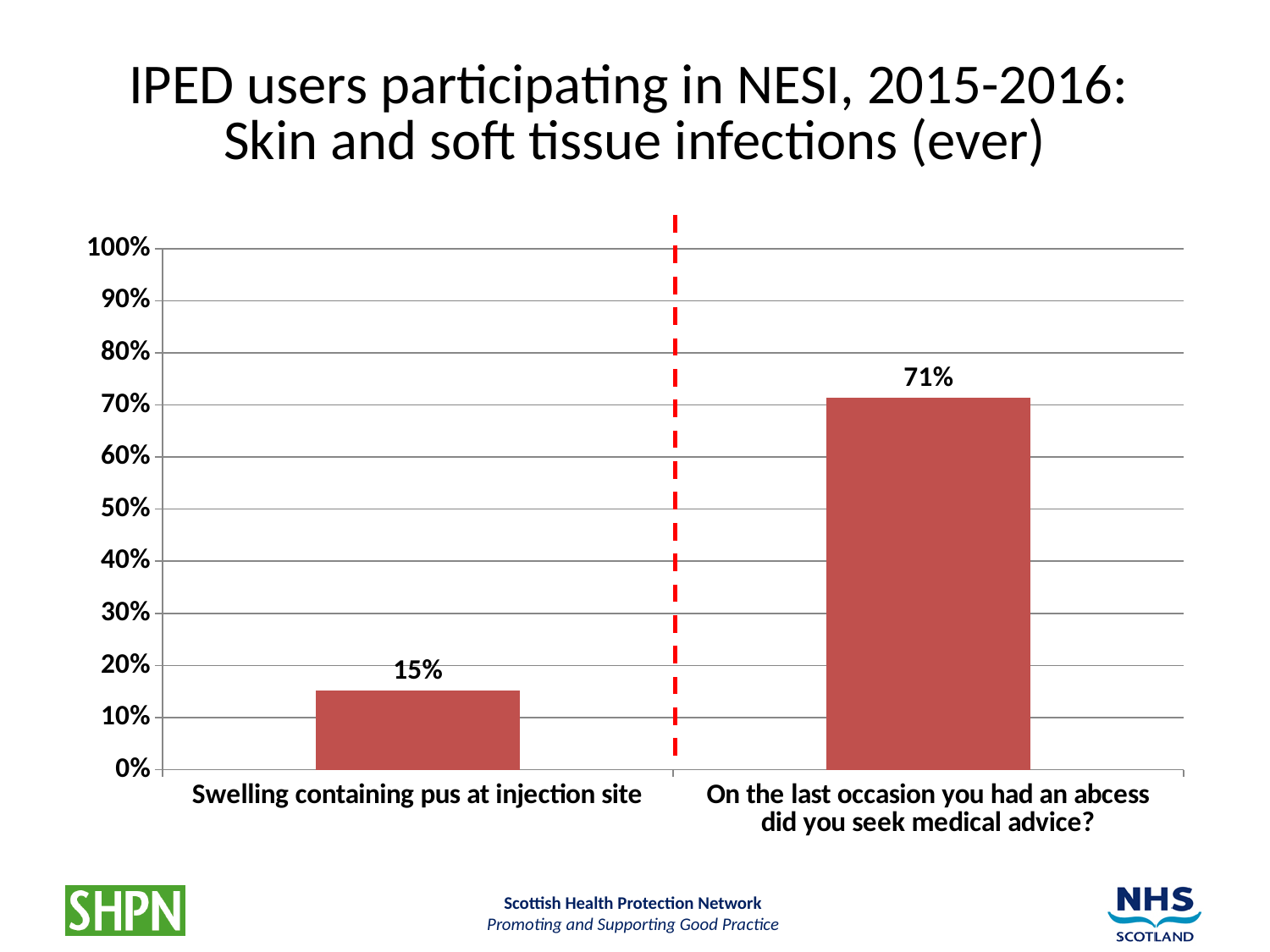
What is the value for "On the last occasion you had an abcess did you seek medical advice?"? 71% What is the value for "Swelling containing pus at injection site"? 15% What is the maximum value shown on the vertical axis? 100% What kind of chart is shown on the slide? Bar chart What is the difference between the value for "On the last occasion you had an abcess did you seek medical advice?" and the value for "Swelling containing pus at injection site"? 56% Which category has the lowest value? Swelling containing pus at injection site Which category has the highest value? On the last occasion you had an abcess did you seek medical advice? How many categories are shown on the chart? 2 Is the value for "Swelling containing pus at injection site" greater or less than 20%? less Is the value for "On the last occasion you had an abcess did you seek medical advice?" greater or less than 60%? greater What colour are the bars in the chart? Red Which is larger: the value for "Swelling containing pus at injection site" or the value for "On the last occasion you had an abcess did you seek medical advice?"? On the last occasion you had an abcess did you seek medical advice?